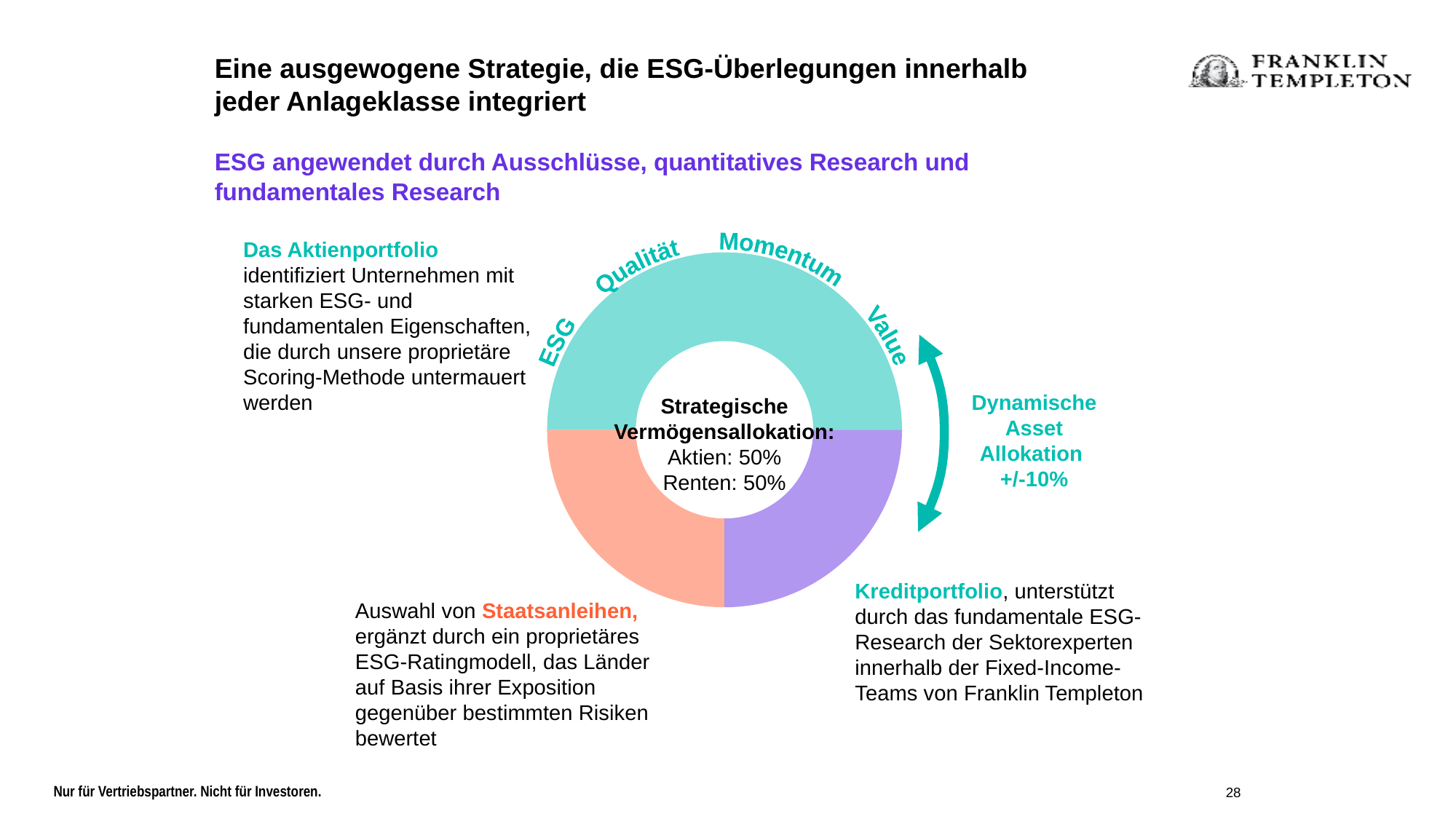
What share of the strategic asset allocation is Renten (bonds) according to the text in the centre of the donut chart? 50% How many coloured segments does the donut chart have? 3 Is the share for Aktien greater or less than 25%? greater What share of the strategic asset allocation is Aktien (equities) according to the text in the centre of the donut chart? 50% What is the total of the Aktien and Renten shares shown in the centre of the chart? 100% What kind of chart is shown on the slide? Donut (pie) chart Is the share for Aktien larger than, smaller than, or equal to the share for Renten? Equal Which colour is the segment representing Staatsanleihen (government bonds)? Orange Which colour is the segment representing the Aktienportfolio (equity portfolio)? Teal What range of dynamic asset allocation is indicated by the arrow next to the chart? +/-10% Which four factors are labelled around the teal (equity) segment of the donut chart? ESG, Qualität, Momentum, Value